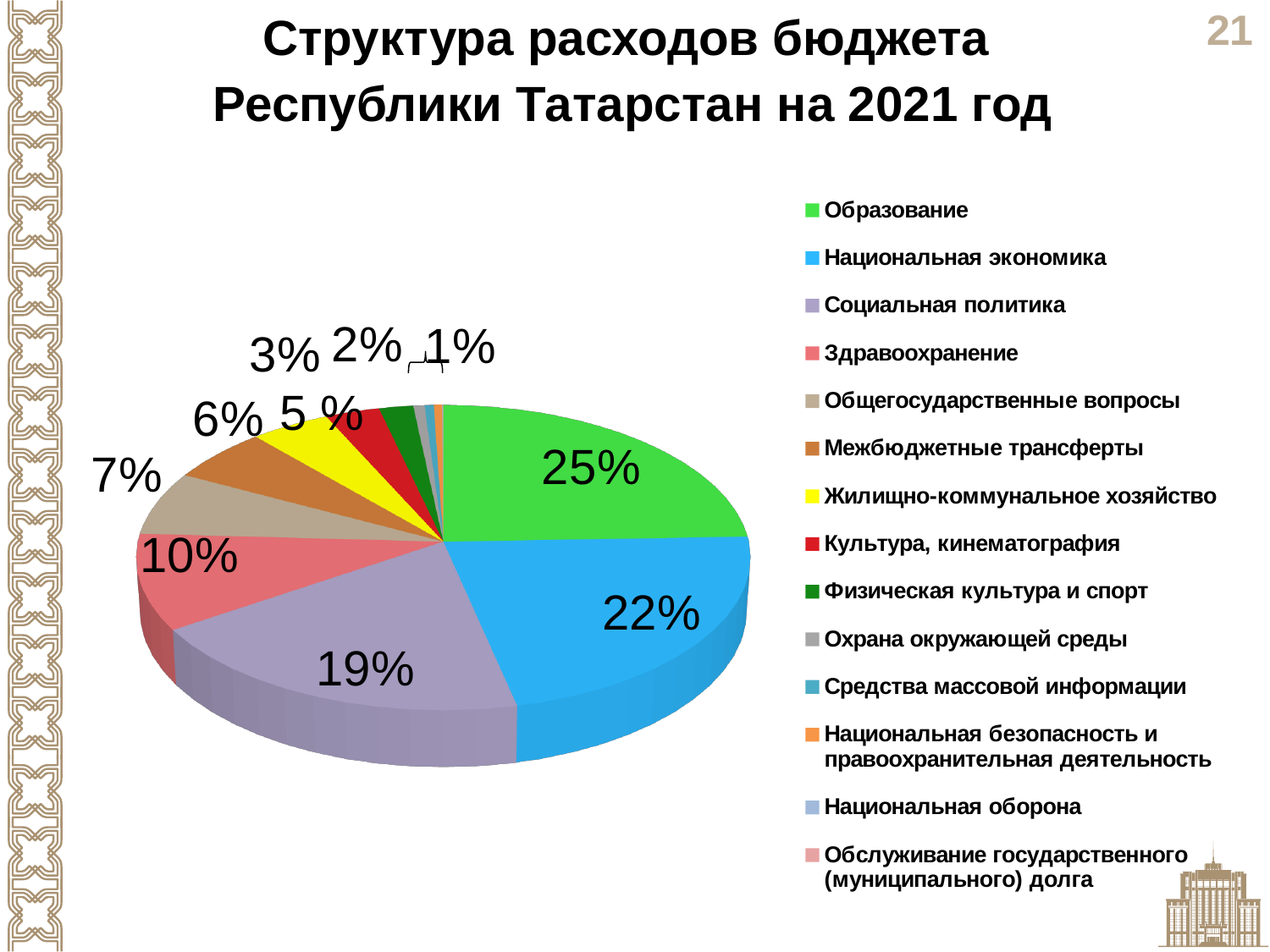
What share of the budget expenditure goes to Жилищно-коммунальное хозяйство? 5% What share of the budget expenditure goes to Национальная экономика? 22% What share of the budget expenditure goes to Общегосударственные вопросы? 7% How many categories does the legend list? 14 What share of the budget expenditure goes to Социальная политика? 19% What colour is the slice for Образование? Green What share of the budget expenditure goes to Образование? 25% What share of the budget expenditure goes to Здравоохранение? 10% Which has a larger share: Социальная политика or Здравоохранение? Социальная политика What kind of chart is shown on the slide? Pie chart Which category has the largest share of the budget expenditure? Образование By how many percentage points does the share for Образование exceed the share for Национальная экономика? 3 percentage points